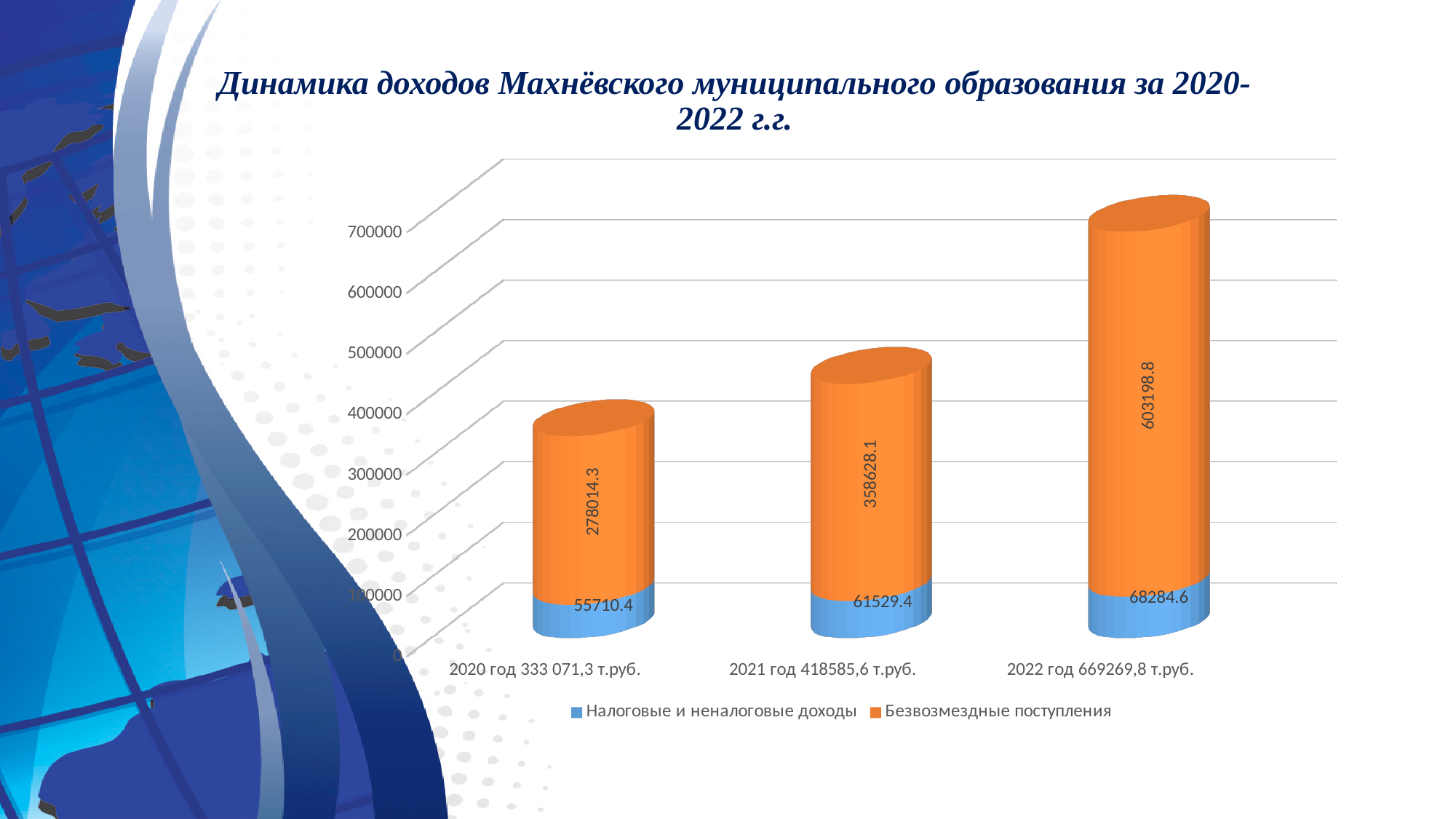
Which year has the highest value for Безвозмездные поступления? 2022 What is the difference between Безвозмездные поступления in 2022 and in 2021? 244570.7 Do the values for Безвозмездные поступления rise or fall from 2020 to 2022? Rise Which is larger: Налоговые и неналоговые доходы in 2021 or in 2022? 2022 What is the value of Безвозмездные поступления for 2022? 603198.8 What type of chart is shown on the slide? Bar chart What is the value of Налоговые и неналоговые доходы for 2020? 55710.4 How many years (categories) are plotted on the x axis? 3 Which year has the lowest value for Налоговые и неналоговые доходы? 2020 What is the value of Безвозмездные поступления for 2021? 358628.1 How many series does the legend list? 2 Which colour represents Налоговые и неналоговые доходы in the chart? Blue